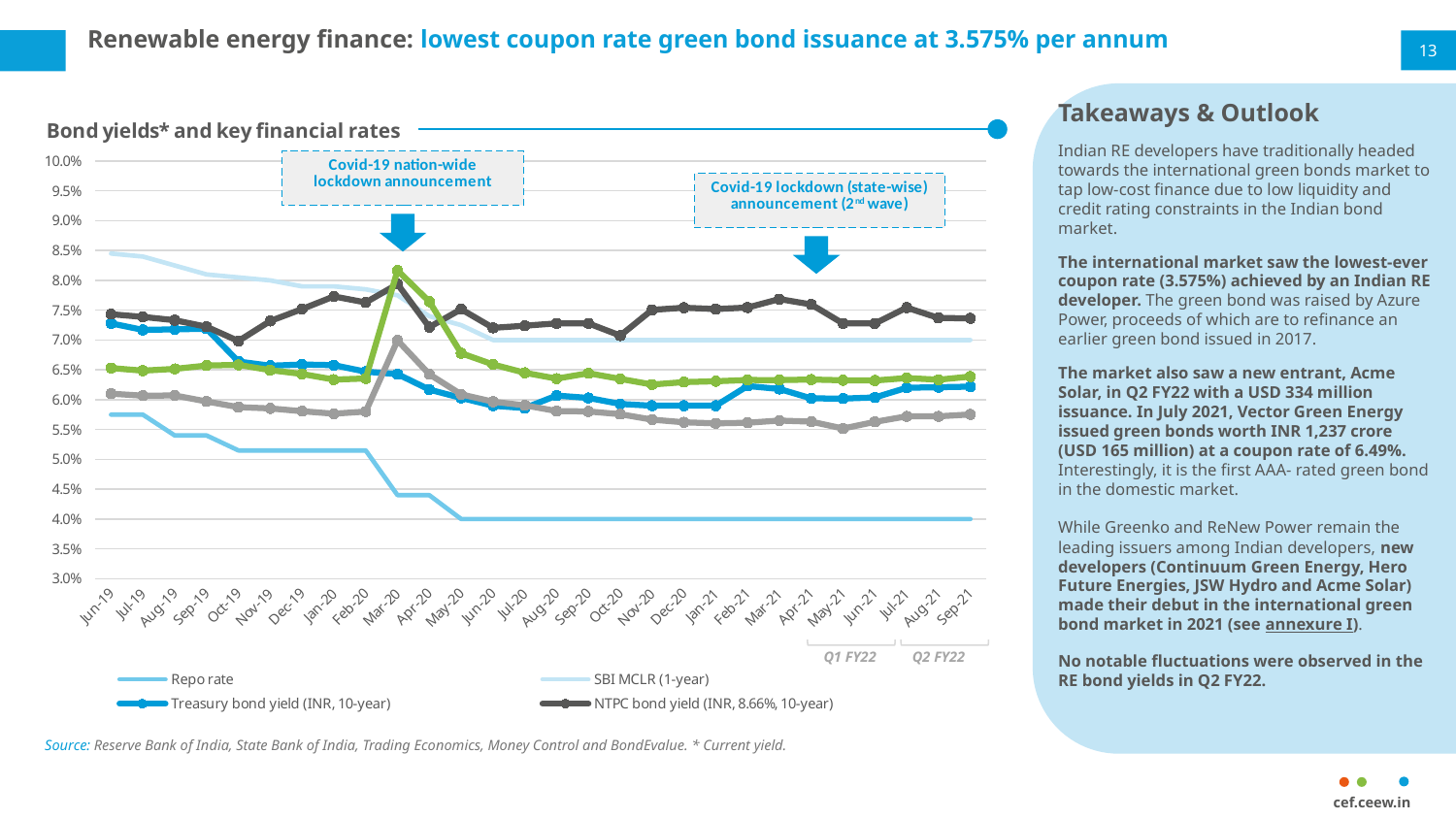
What is the Repo rate in Sep-21? 4.0% What type of chart is shown on the slide? Line chart How many months are shown along the x axis of the chart? 28 Which series has the highest value in Sep-21? NTPC bond yield (INR, 8.66%, 10-year) Is the Treasury bond yield (INR, 10-year) in Sep-21 greater or less than 6.0%? greater What is the title of the chart? Bond yields* and key financial rates Is the Repo rate in Jun-19 greater or less than 6.0%? less How many series does the chart legend list? 4 In Sep-21, which is larger: the Repo rate or the SBI MCLR (1-year)? SBI MCLR (1-year) Does the Repo rate rise or fall from Jun-19 to Sep-21? Fall Is the NTPC bond yield in Sep-21 greater or less than 7.0%? greater Which series has the lowest value in Sep-21? Repo rate